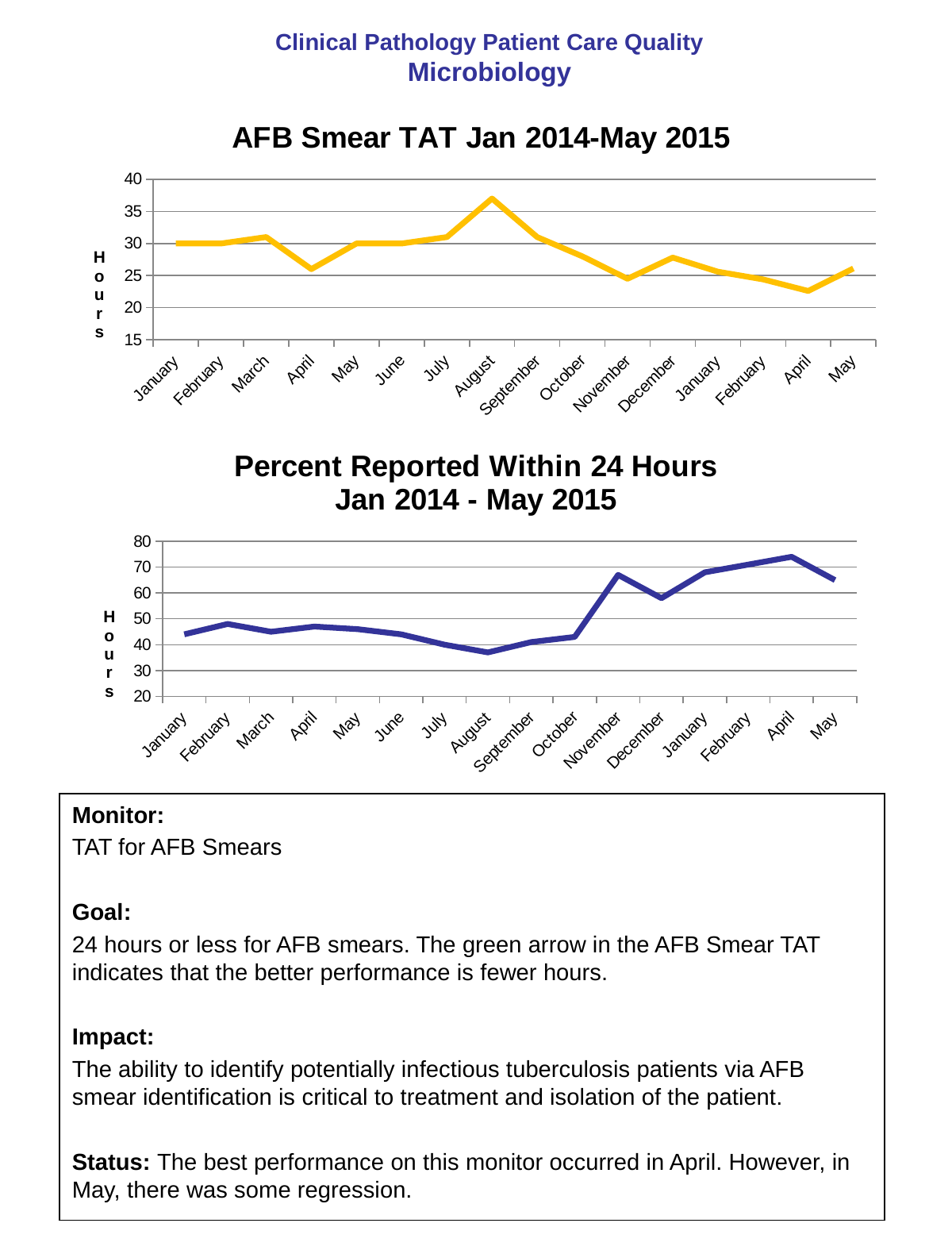
How many charts are shown on the slide? 2 How many data points are plotted in the 'AFB Smear TAT Jan 2014-May 2015' chart? 16 In the 'Percent Reported Within 24 Hours Jan 2014 - May 2015' chart, do the values overall rise or fall from the first January to the final May? rise In the 'Percent Reported Within 24 Hours Jan 2014 - May 2015' chart, which month has the highest value? April (2015) In the 'AFB Smear TAT Jan 2014-May 2015' chart, is the value for the second April on the x axis (April 2015) greater or less than 25? less In the 'Percent Reported Within 24 Hours Jan 2014 - May 2015' chart, is the value for November greater or less than 60? greater In the 'Percent Reported Within 24 Hours Jan 2014 - May 2015' chart, is the value for August greater or less than 40? less In the 'AFB Smear TAT Jan 2014-May 2015' chart, which month has the highest value? August In the 'Percent Reported Within 24 Hours Jan 2014 - May 2015' chart, which month has the lowest value? August In the 'AFB Smear TAT Jan 2014-May 2015' chart, which is larger, the value for August or the value for the first April on the x axis? August What kind of chart is the 'AFB Smear TAT Jan 2014-May 2015' chart? line chart